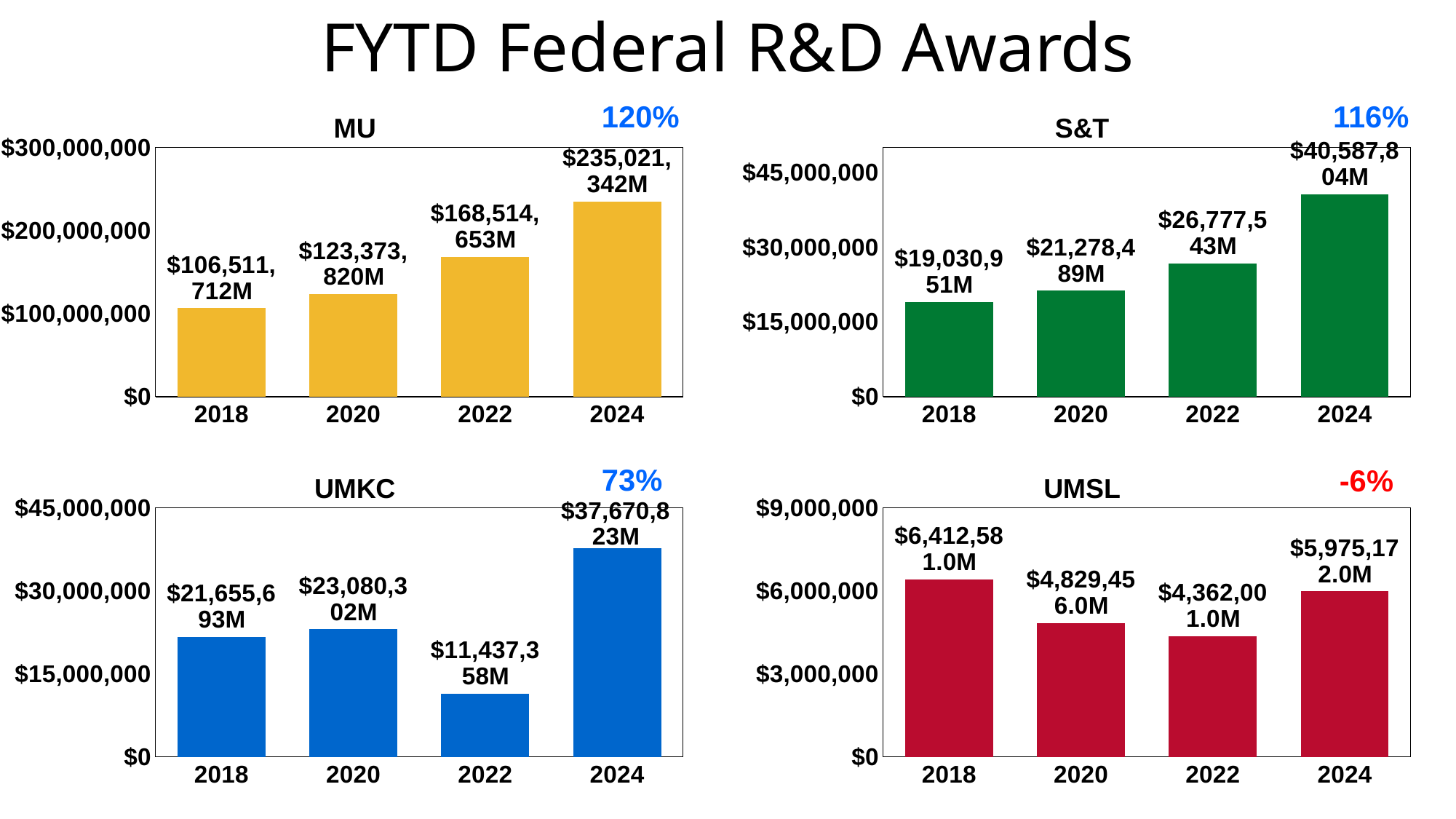
In the UMKC chart, what is the value for 2022? $11,437,358M What percentage is shown above the UMSL chart? -6% In the S&T chart, how many years are plotted? 4 In the UMSL chart, which is larger, the value for 2018 or the value for 2024? 2018 In the UMKC chart, which year has the lowest value? 2022 What kind of chart is the MU chart? bar chart In the MU chart, what is the value for 2024? $235,021,342M In the MU chart, do the values rise or fall from 2018 to 2024? rise In the UMSL chart, what is the value for 2020? $4,829,456.0M In the S&T chart, is the value for 2024 greater or less than $30,000,000? greater In the UMSL chart, which year has the highest value? 2018 In the S&T chart, what is the value for 2018? $19,030,951M